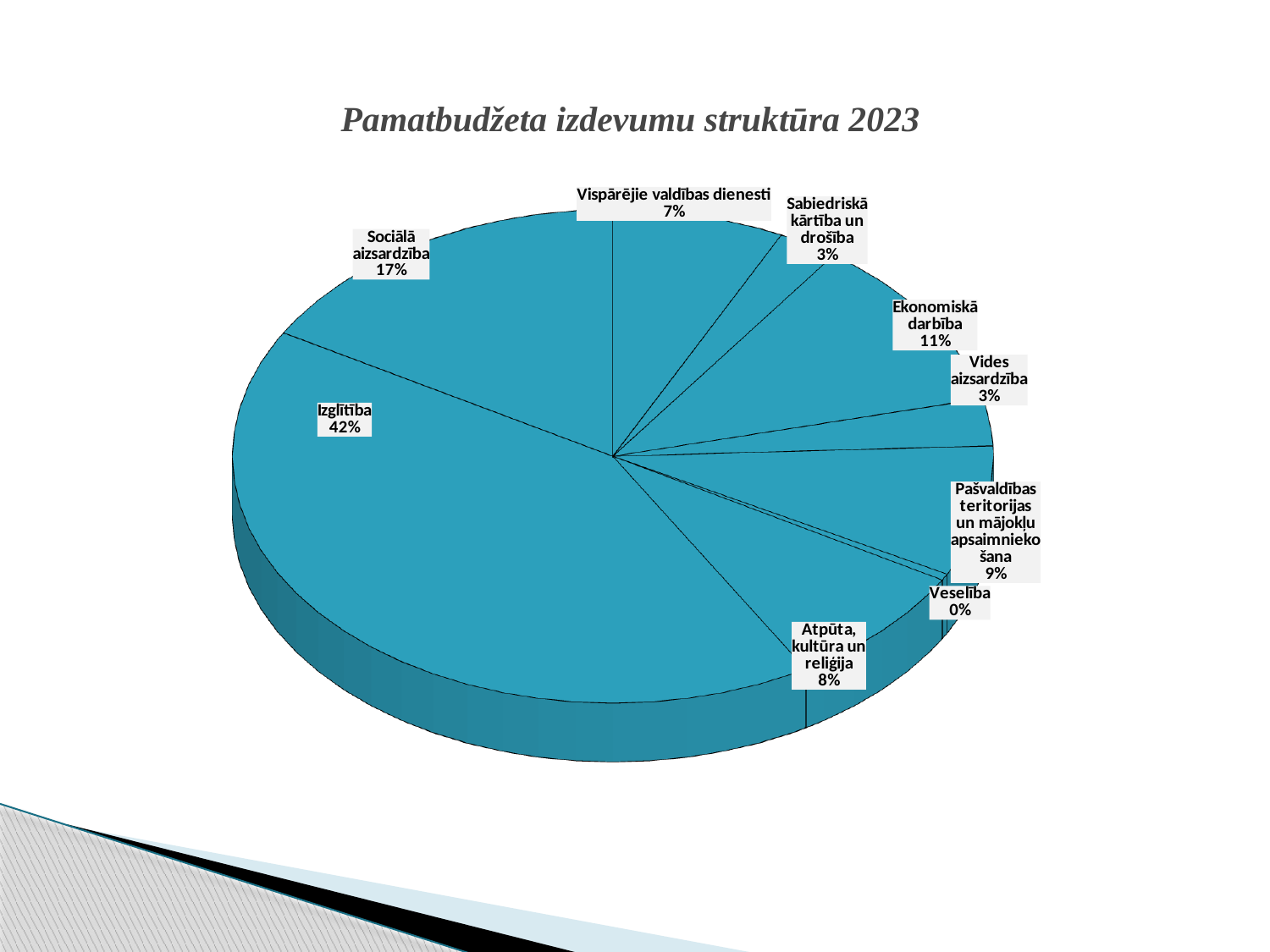
What is the difference between the shares of Izglītība and Sociālā aizsardzība? 25% What is the value shown for Atpūta, kultūra un reliģija? 8% How many categories are shown in the pie chart? 9 What is the title of the chart? Pamatbudžeta izdevumu struktūra 2023 What is the value shown for Pašvaldības teritorijas un mājokļu apsaimniekošana? 9% What is the value shown for Ekonomiskā darbība? 11% What kind of chart is shown on the slide? pie chart What share of the pie does Sociālā aizsardzība have? 17% Which is larger, the share for Ekonomiskā darbība or the share for Vispārējie valdības dienesti? Ekonomiskā darbība Which category has the largest slice of the pie? Izglītība Which category has the smallest slice of the pie? Veselība What share of the pie does Izglītība have? 42%